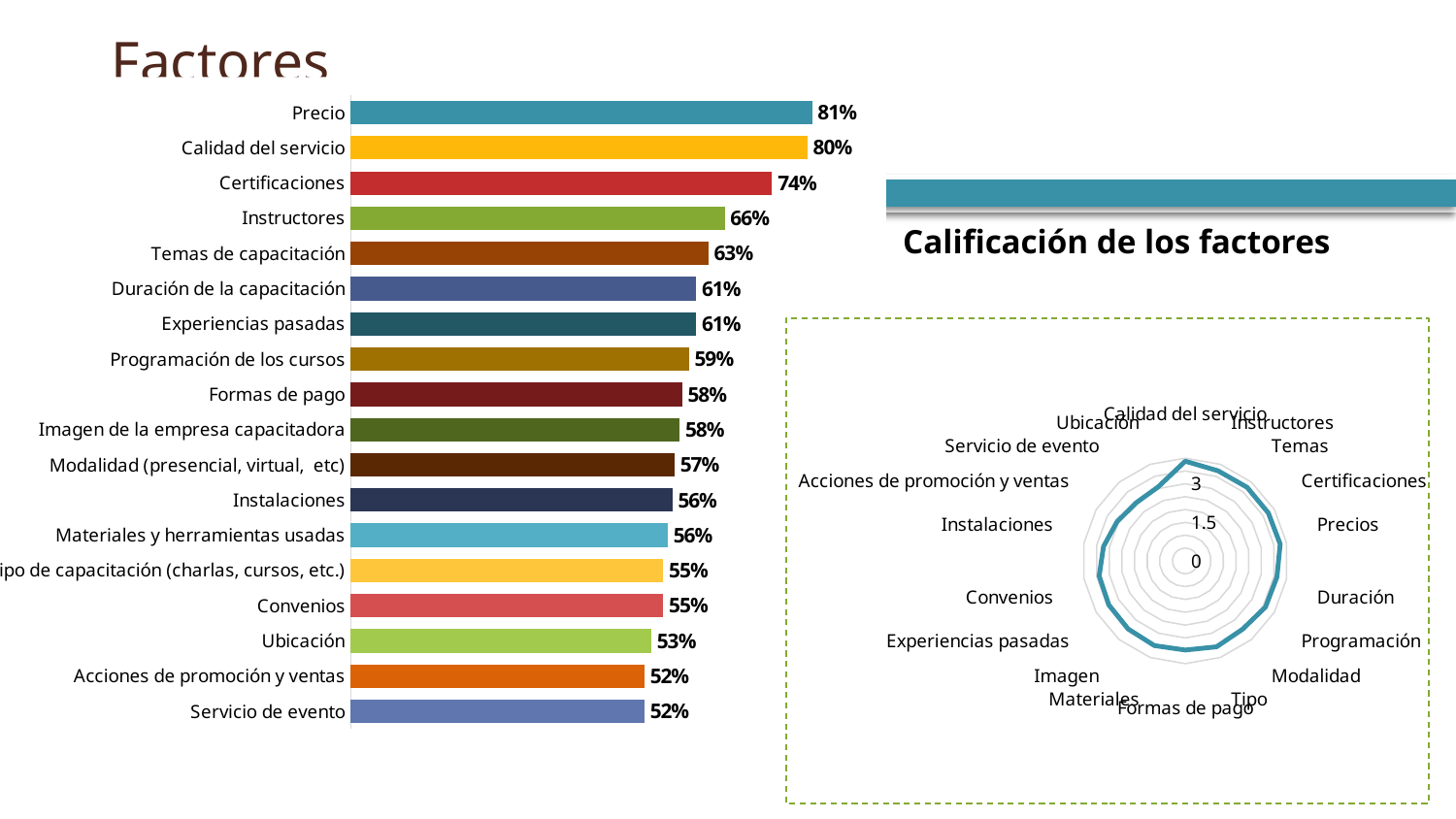
In the 'Factores' bar chart, which is larger: Instructores or Convenios? Instructores In the 'Factores' bar chart, do the values rise or fall from the top category to the bottom category? Fall In the 'Factores' bar chart, what is the value for Ubicación? 53% What kind of chart is the 'Factores' chart on the left of the slide? Bar chart In the 'Factores' bar chart, what is the value for Certificaciones? 74% How many categories are shown in the 'Factores' bar chart? 18 What kind of chart is 'Calificación de los factores' on the right of the slide? Radar chart In the 'Factores' bar chart, which category has the highest value? Precio In the 'Factores' bar chart, what is the difference between Certificaciones and Servicio de evento? 22% In the 'Factores' bar chart, what is the value for Temas de capacitación? 63% In the 'Calificación de los factores' radar chart, is the value for Precios greater or less than 1.5? greater In the 'Factores' bar chart, what is the difference between Precio and Calidad del servicio? 1%